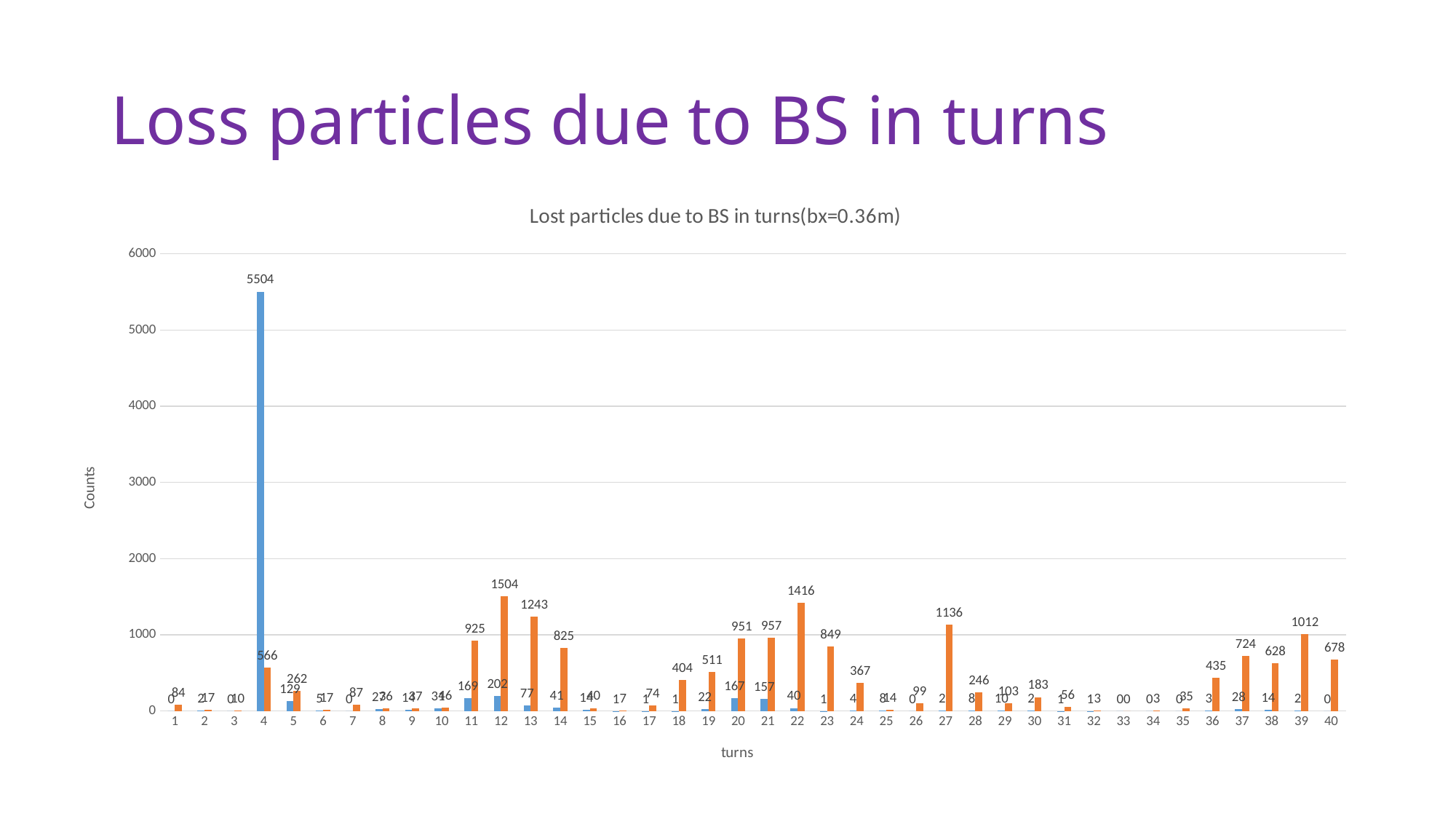
What is the difference between the blue bar and the orange bar at turn 4? 4938 How many turns (categories) are plotted along the x axis? 40 What is the value of the orange bar at turn 22? 1416 What is the value of the orange bar at turn 12? 1504 Is the value of the orange bar at turn 27 greater or less than 1000? greater Which is larger at turn 13: the blue bar or the orange bar? the orange bar What is the value of the blue bar at turn 4? 5504 What type of chart is shown on the slide? bar chart At which turn does the blue series reach its highest value? 4 At which turn does the orange series reach its highest value? 12 What is the title of the chart? Lost particles due to BS in turns(bx=0.36m) What label is shown on the vertical axis? Counts